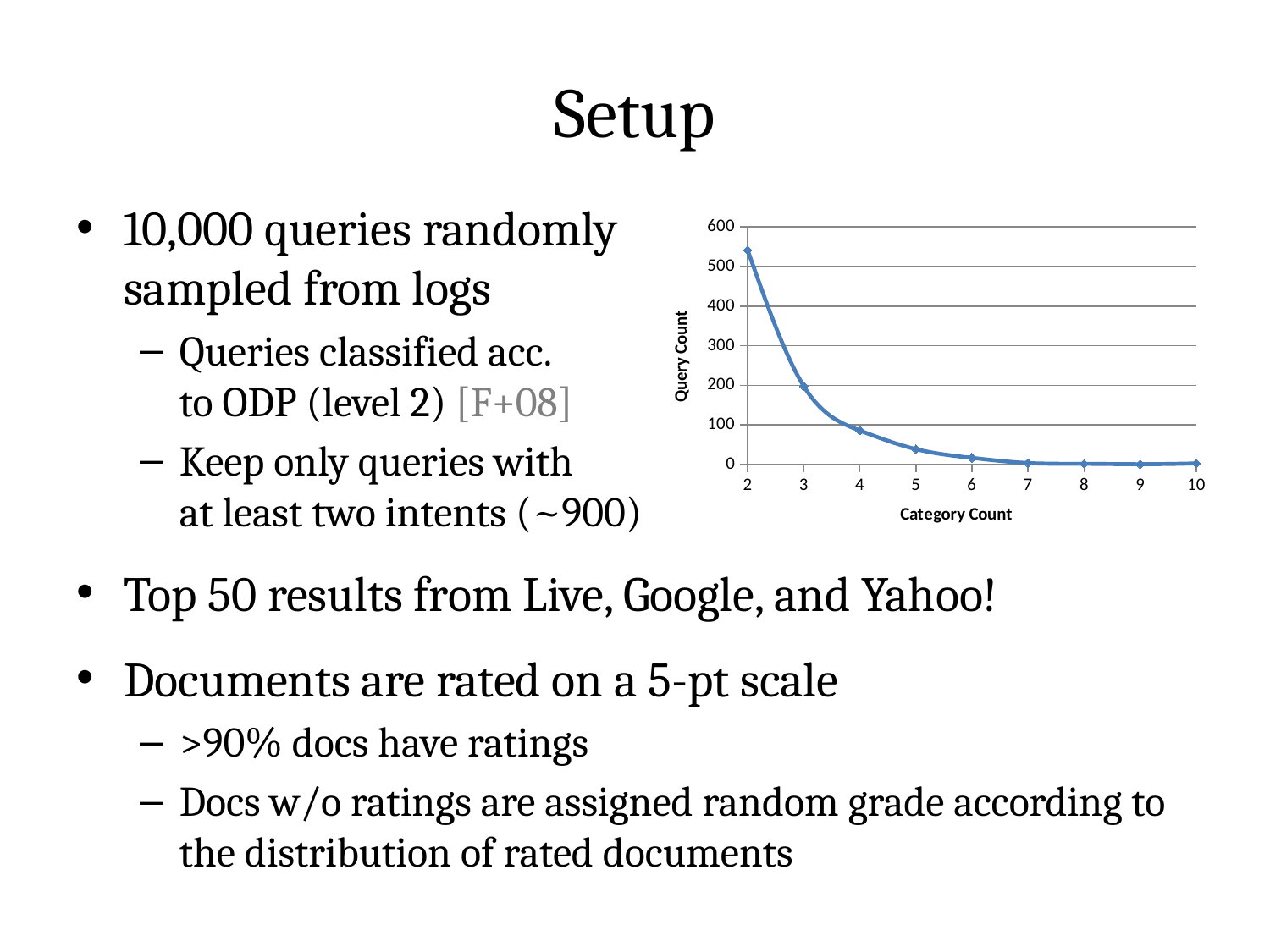
Does the query count rise or fall as the category count increases? fall Is the query count for category count 2 greater or less than 400? greater Is the query count for category count 3 greater or less than 100? greater How many data points are plotted on the line? 9 What is the label of the x axis? Category Count Is the query count for category count 4 greater or less than 200? less Which has a larger query count, category count 3 or category count 6? category count 3 What kind of chart is shown on the slide? line chart Which category count has the highest query count? 2 What is the label of the y axis? Query Count